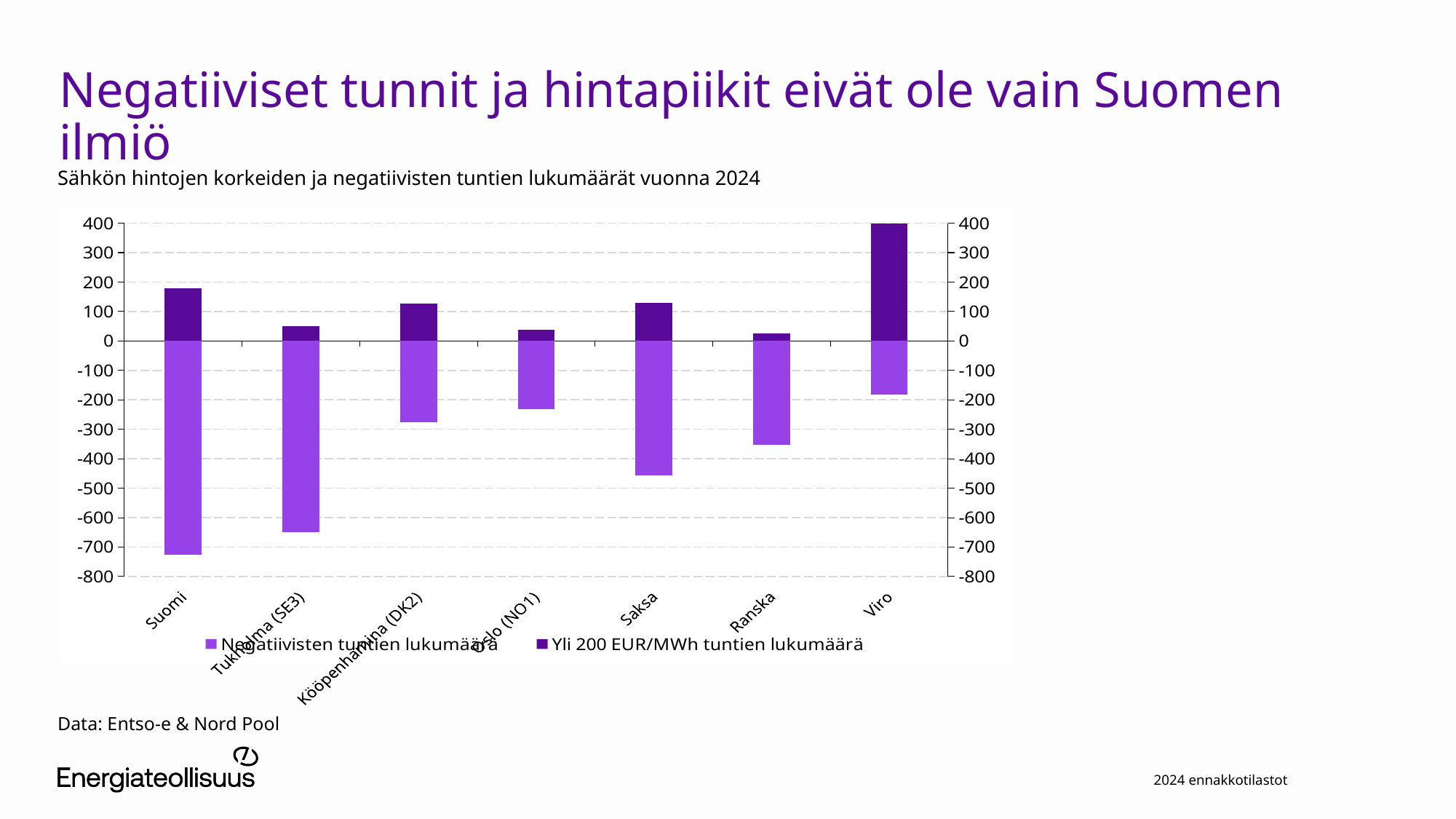
Is the 'Negatiivisten tuntien lukumäärä' value for Suomi greater or less than -700? less What kind of chart is shown on the slide? bar chart Which has the more negative 'Negatiivisten tuntien lukumäärä' value, Tukholma (SE3) or Saksa? Tukholma (SE3) How many countries or price areas are shown on the x axis of the chart? 7 Is the 'Yli 200 EUR/MWh tuntien lukumäärä' value for Suomi greater or less than 100? greater Which category has the lowest (most negative) value for 'Negatiivisten tuntien lukumäärä'? Suomi How many series does the chart legend list? 2 Is the 'Negatiivisten tuntien lukumäärä' value for Tukholma (SE3) greater or less than -600? less Which has the larger 'Yli 200 EUR/MWh tuntien lukumäärä' value, Suomi or Viro? Viro Which category has the highest value for 'Yli 200 EUR/MWh tuntien lukumäärä'? Viro What is the subtitle describing the chart's content? Sähkön hintojen korkeiden ja negatiivisten tuntien lukumäärät vuonna 2024